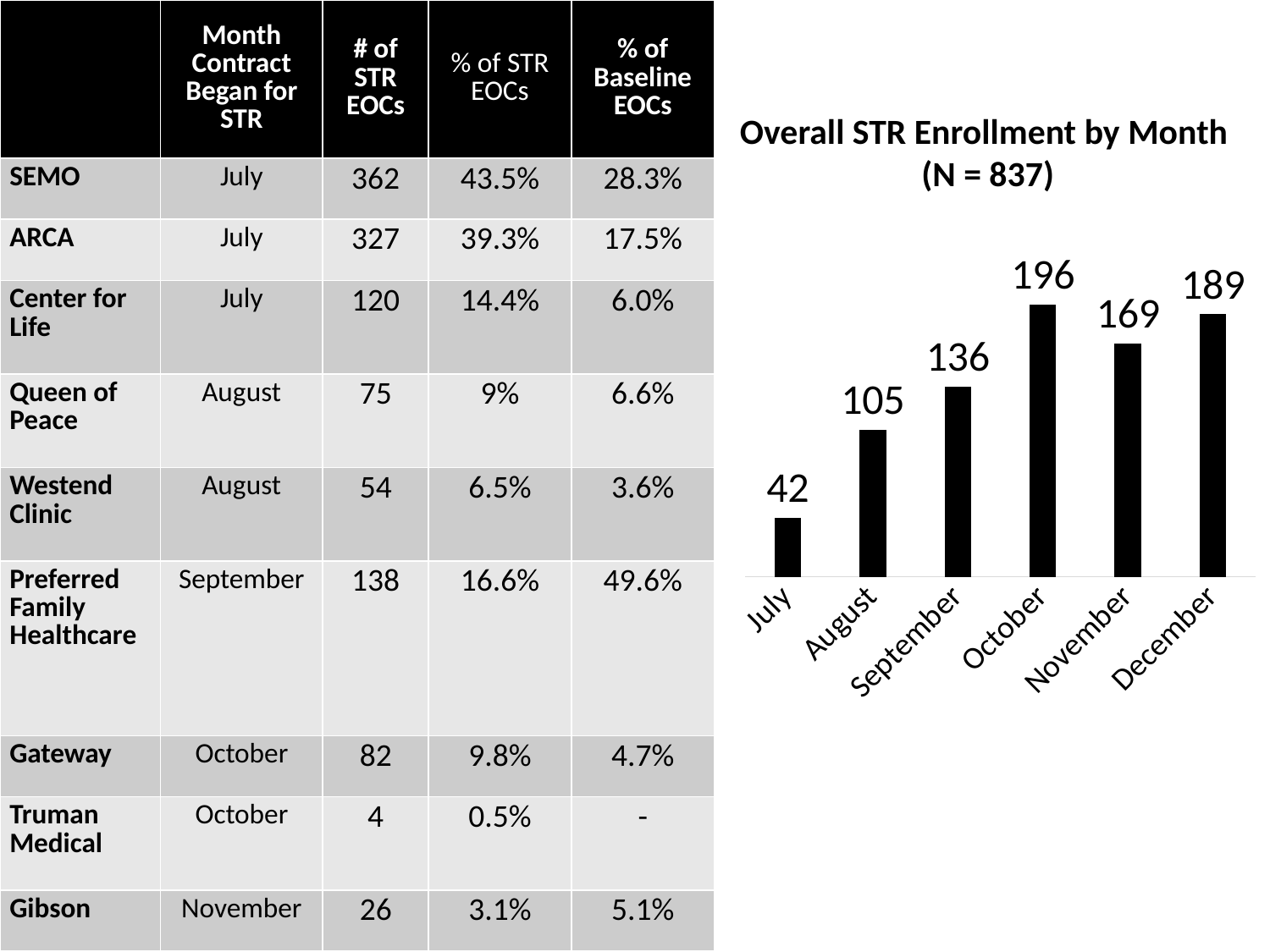
How many months are shown in the Overall STR Enrollment by Month chart? 6 Do the values in the Overall STR Enrollment by Month chart rise or fall from July to October? rise What is the value for October in the Overall STR Enrollment by Month chart? 196 What is the N value given in the title of the Overall STR Enrollment by Month chart? 837 Which month has the lowest enrollment in the Overall STR Enrollment by Month chart? July What is the value for July in the Overall STR Enrollment by Month chart? 42 What is the difference between the October and November values in the Overall STR Enrollment by Month chart? 27 What is the difference between the August and July values in the Overall STR Enrollment by Month chart? 63 What kind of chart is the Overall STR Enrollment by Month chart? bar chart What is the value for November in the Overall STR Enrollment by Month chart? 169 Which month has the highest enrollment in the Overall STR Enrollment by Month chart? October Which is larger in the Overall STR Enrollment by Month chart, September or December? December